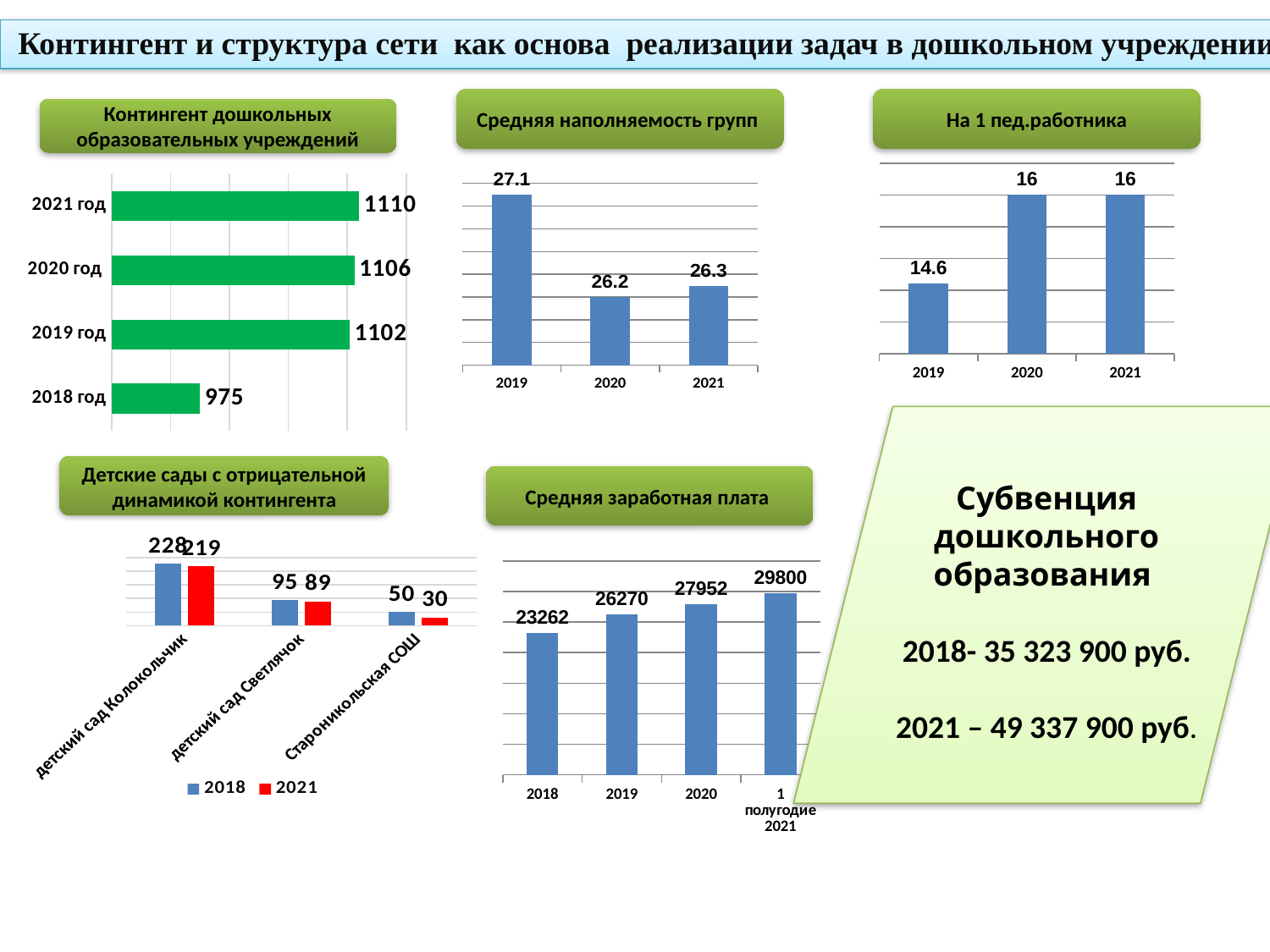
In the chart 'Контингент дошкольных образовательных учреждений', what is the value for 2021 год? 1110 In the chart 'Детские сады с отрицательной динамикой контингента', what is the 2021 value for Старониколькая СОШ? 30 What kind of chart is 'Контингент дошкольных образовательных учреждений'? bar chart In the chart 'Средняя заработная плата', do the values rise or fall from 2018 to 1 полугодие 2021? rise In the chart 'Контингент дошкольных образовательных учреждений', which year has the lowest value? 2018 год In the chart 'Средняя наполняемость групп', which year has the highest value? 2019 In the chart 'Средняя наполняемость групп', what is the value for 2020? 26.2 How many bars are shown in the chart 'На 1 пед.работника'? 3 How many series does the legend of the chart 'Детские сады с отрицательной динамикой контингента' list? 2 In the chart 'Средняя заработная плата', what is the value for 2019? 26270 In the chart 'На 1 пед.работника', what is the value for 2019? 14.6 In the chart 'Контингент дошкольных образовательных учреждений', what is the difference between the values for 2019 год and 2018 год? 127